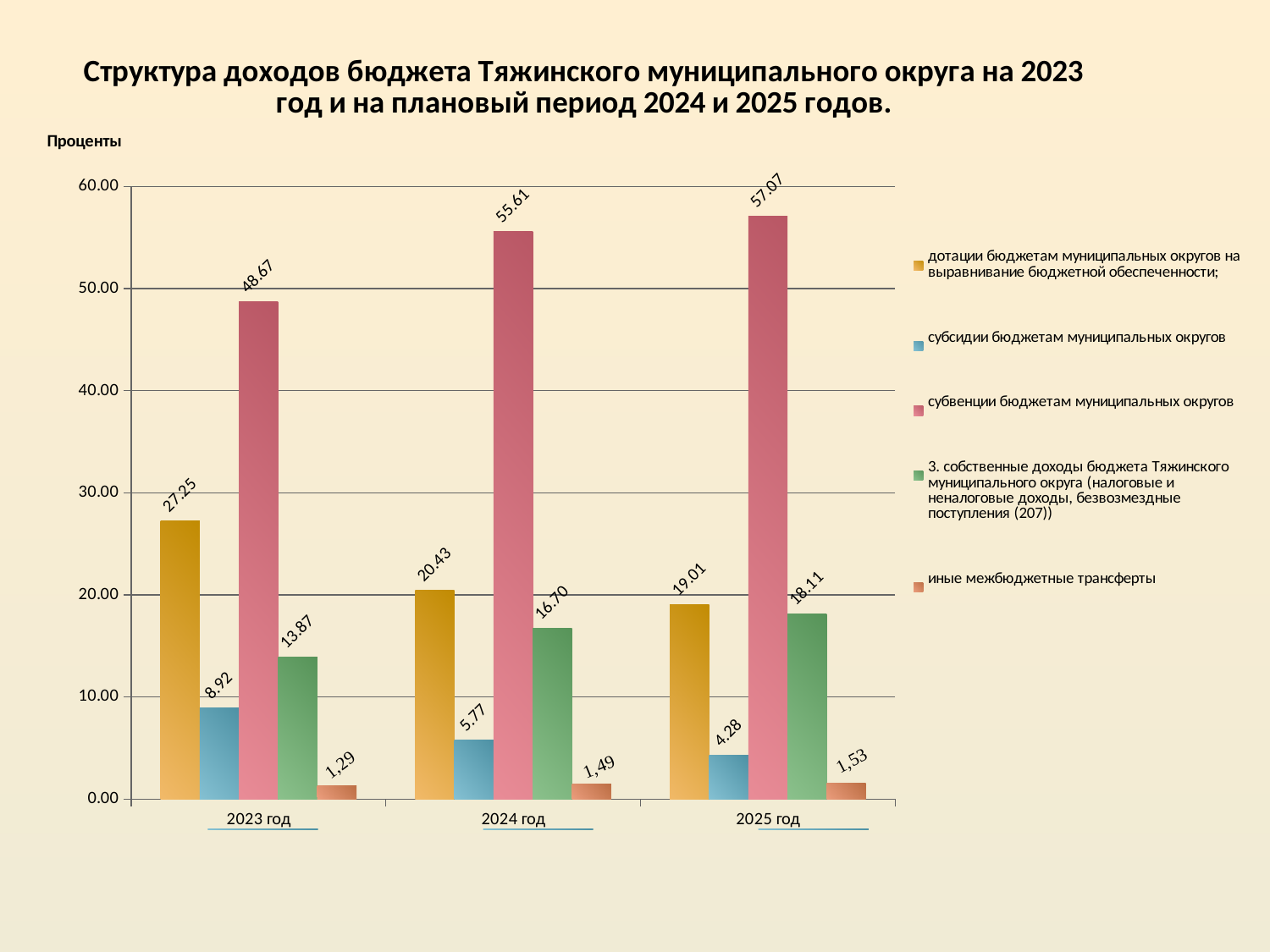
In which year is the value for субсидии бюджетам муниципальных округов the lowest? 2025 год What is the value for субвенции бюджетам муниципальных округов in 2024 год? 55.61 What is the difference between the values for собственные доходы бюджета in 2025 год and 2023 год? 4.24 Which is larger: дотации in 2024 год or дотации in 2025 год? 2024 год How many years are shown on the x axis? 3 What is the value for иные межбюджетные трансферты in 2025 год? 1,53 How many series does the legend list? 5 In which year is the value for субвенции бюджетам муниципальных округов the highest? 2025 год Is the value for субвенции бюджетам муниципальных округов in 2023 год greater or less than 50.00? less Does the value for дотации бюджетам муниципальных округов rise or fall from 2023 год to 2025 год? fall What is the value for дотации бюджетам муниципальных округов на выравнивание бюджетной обеспеченности in 2023 год? 27.25 What is the value for субсидии бюджетам муниципальных округов in 2024 год? 5.77